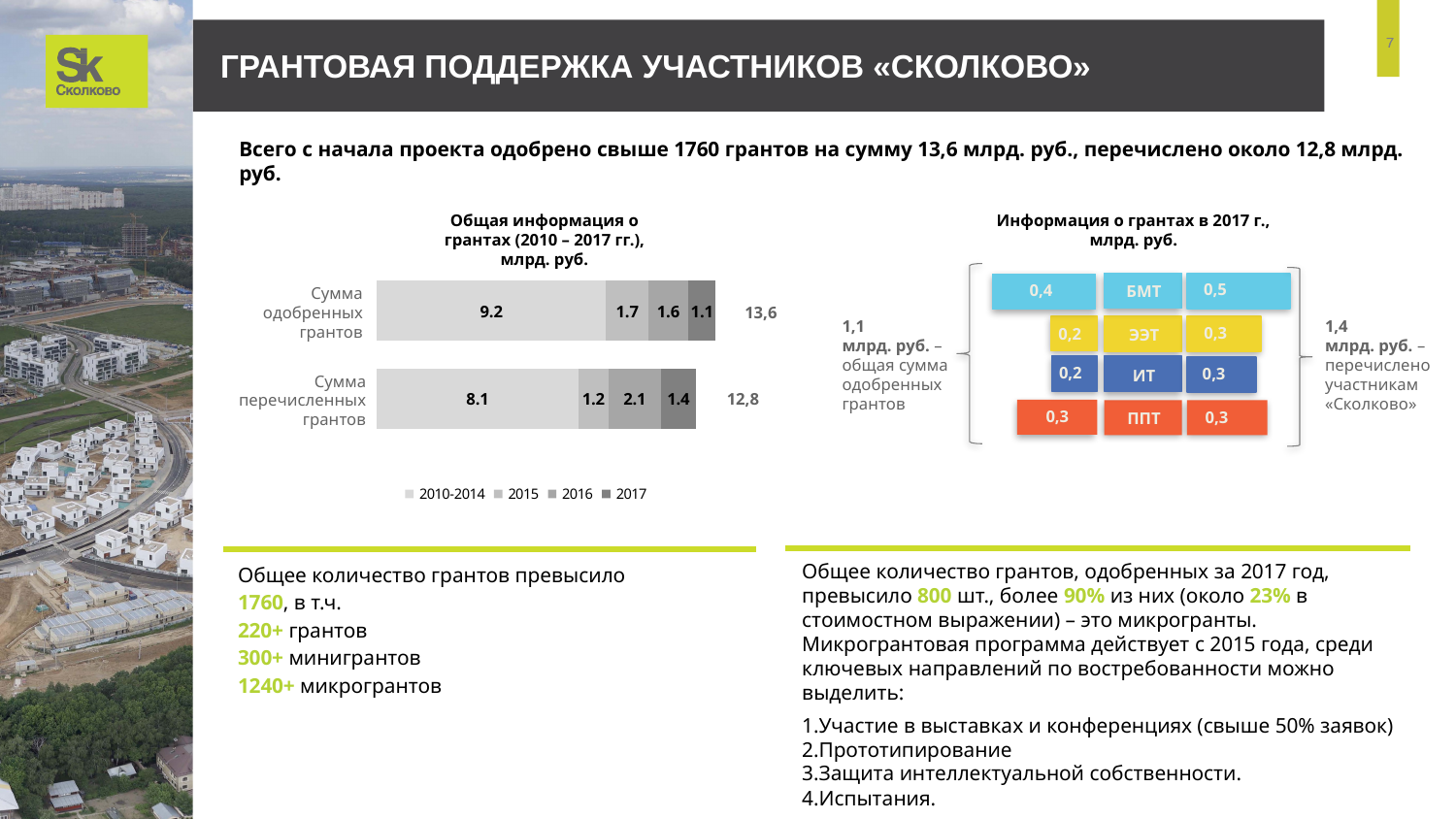
How many categories (bars) does the chart 'Общая информация о грантах (2010 – 2017 гг.), млрд. руб.' have? 2 In the chart 'Общая информация о грантах (2010 – 2017 гг.), млрд. руб.', what is the difference between the 2010-2014 segments of 'Сумма одобренных грантов' and 'Сумма перечисленных грантов'? 1.1 In the chart 'Общая информация о грантах (2010 – 2017 гг.), млрд. руб.', what is the value of the 2015 segment for 'Сумма одобренных грантов'? 1.7 In the chart 'Общая информация о грантах (2010 – 2017 гг.), млрд. руб.', what is the value of the 2010-2014 segment for 'Сумма одобренных грантов'? 9.2 In the chart 'Общая информация о грантах (2010 – 2017 гг.), млрд. руб.', what is the total shown for the 'Сумма одобренных грантов' bar? 13,6 In the chart 'Общая информация о грантах (2010 – 2017 гг.), млрд. руб.', what is the total shown for the 'Сумма перечисленных грантов' bar? 12,8 In the chart 'Общая информация о грантах (2010 – 2017 гг.), млрд. руб.', what is the value of the 2017 segment for 'Сумма перечисленных грантов'? 1.4 What kind of chart is 'Общая информация о грантах (2010 – 2017 гг.), млрд. руб.'? Stacked bar chart In the chart 'Общая информация о грантах (2010 – 2017 гг.), млрд. руб.', which series has the largest segment in the 'Сумма одобренных грантов' bar? 2010-2014 In the chart 'Общая информация о грантах (2010 – 2017 гг.), млрд. руб.', which series has the smallest segment in the 'Сумма одобренных грантов' bar? 2017 How many series does the legend of the chart 'Общая информация о грантах (2010 – 2017 гг.), млрд. руб.' list? 4 In the chart 'Общая информация о грантах (2010 – 2017 гг.), млрд. руб.', which bar has the larger 2016 segment: 'Сумма одобренных грантов' or 'Сумма перечисленных грантов'? Сумма перечисленных грантов